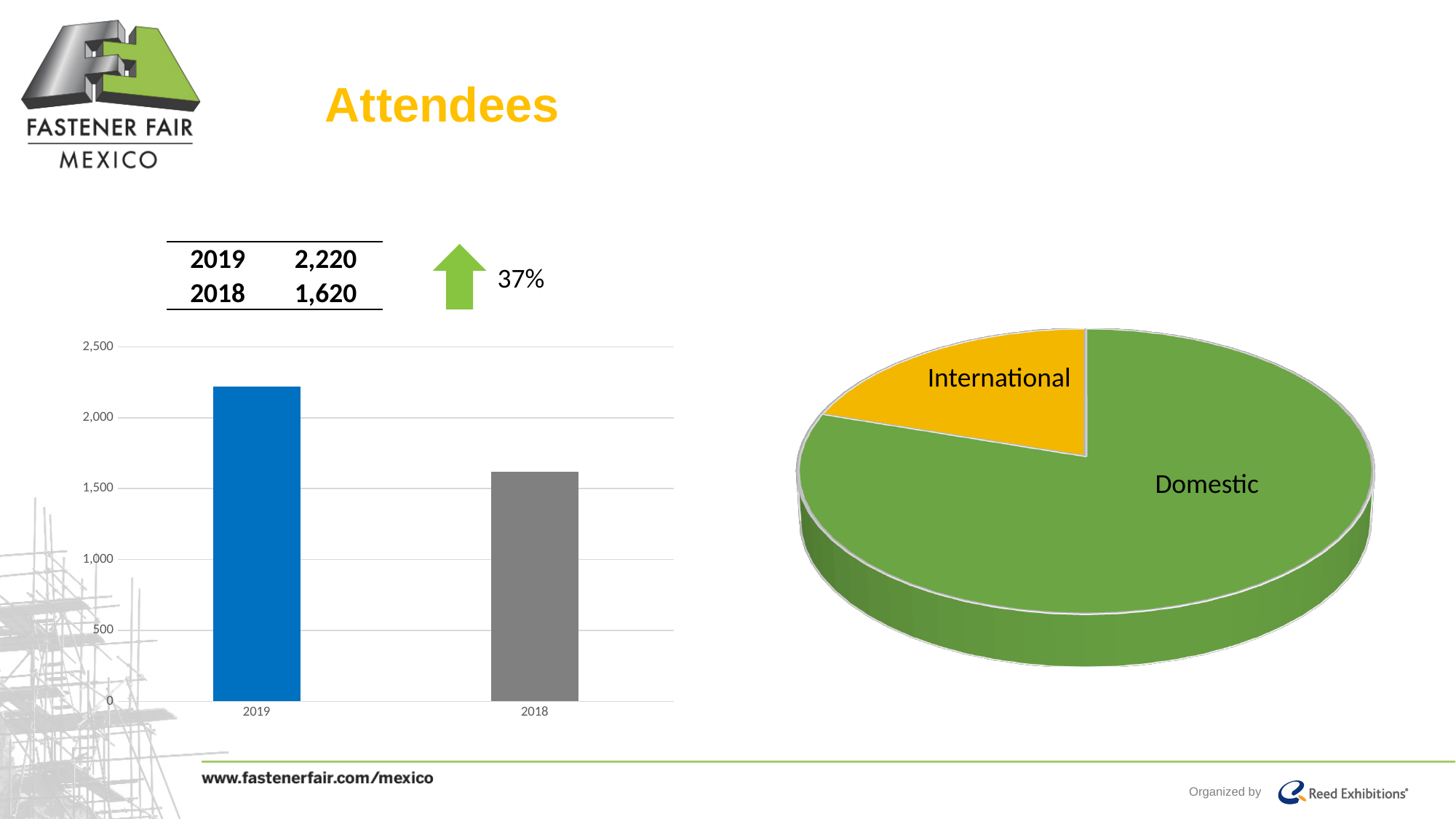
What kind of chart is shown on the right of the slide? Pie chart In the bar chart on the left, which year has the higher bar? 2019 In the bar chart on the left, is the value for 2018 greater or less than 2,000? less In the bar chart on the left, what is the difference between the 2019 and 2018 values? 600 In the pie chart on the right, which slice is the largest? Domestic In the bar chart on the left, what is the attendee value for 2018? 1,620 In the bar chart on the left, what is the attendee value for 2019? 2,220 In the pie chart on the right, what colour is the International slice? Yellow In the bar chart on the left, is the value for 2019 greater or less than 2,000? greater What kind of chart is shown on the left of the slide? Bar chart How many bars are shown in the bar chart on the left? 2 In the bar chart on the left, which year has the lower bar? 2018